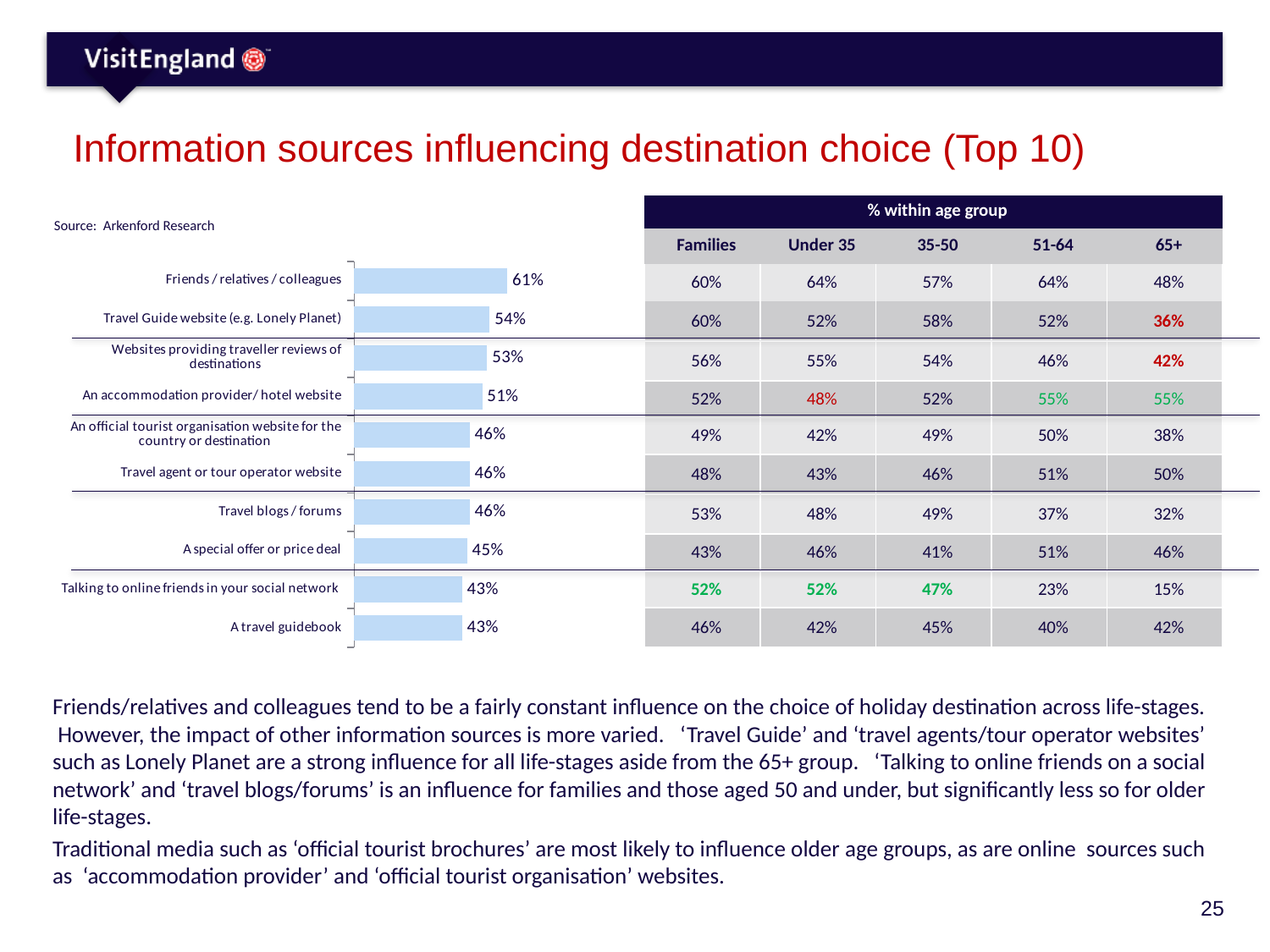
How many information sources are shown in the bar chart? 10 What is the title of the slide containing the bar chart? Information sources influencing destination choice (Top 10) What is the difference between the values for Websites providing traveller reviews of destinations and A travel guidebook in the bar chart? 10 percentage points What is the value for An accommodation provider / hotel website in the bar chart? 51% What is the value for A special offer or price deal in the bar chart? 45% What is the value for Friends / relatives / colleagues in the bar chart? 61% What is the value for Travel Guide website (e.g. Lonely Planet) in the bar chart? 54% What is the difference between the values for Friends / relatives / colleagues and Travel Guide website (e.g. Lonely Planet) in the bar chart? 7 percentage points What is the value for A travel guidebook in the bar chart? 43% Which information source has the highest value in the bar chart? Friends / relatives / colleagues In the bar chart, which is larger: the value for Travel Guide website (e.g. Lonely Planet) or the value for A travel guidebook? Travel Guide website (e.g. Lonely Planet) What kind of chart is used to show the information sources? Bar chart